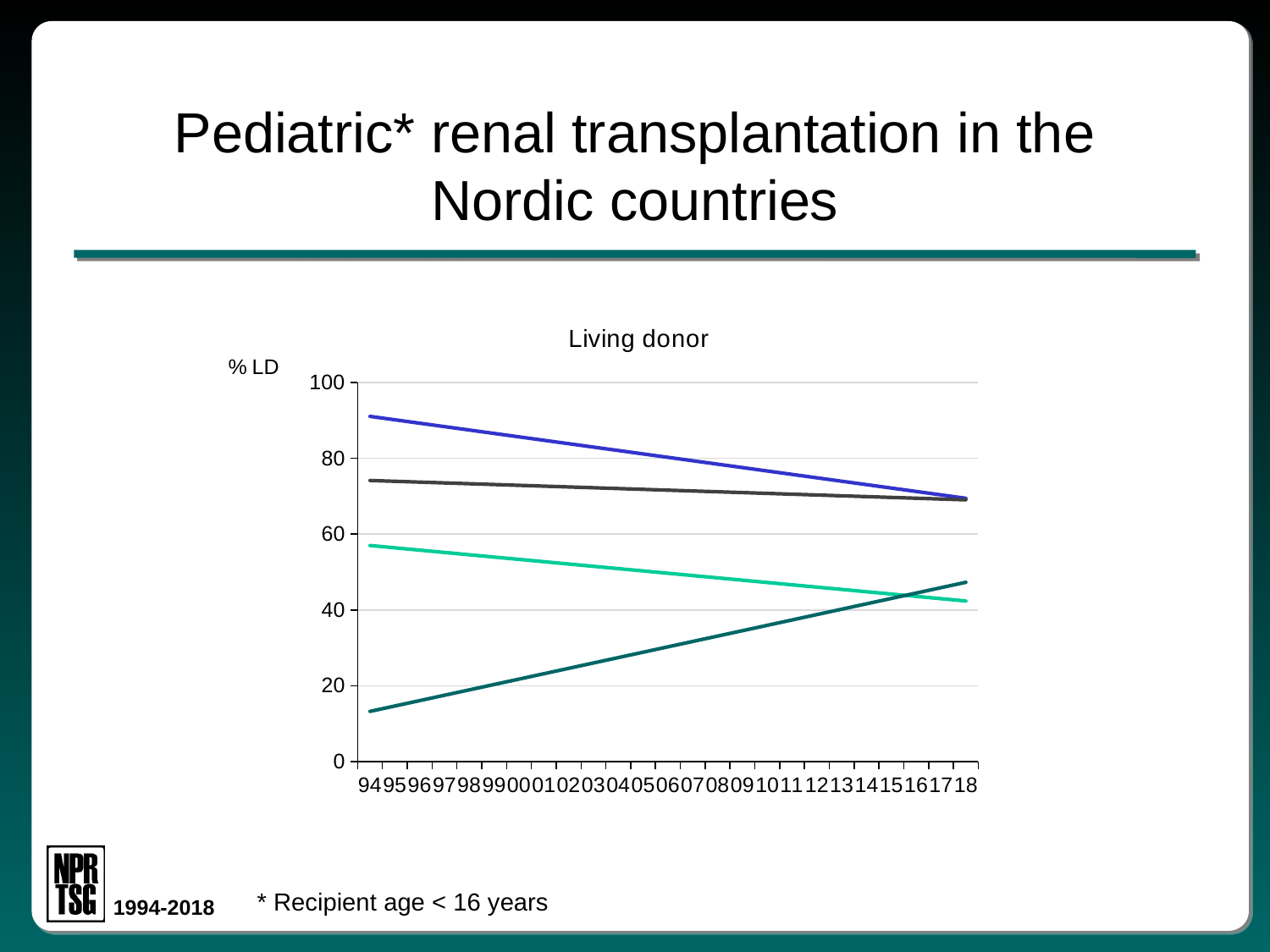
What kind of chart is shown on the slide? line chart Does the dark teal line rise or fall from 94 to 18? rise Which line has the highest value at 94? the blue line What is the title of the chart? Living donor How many lines are plotted on the chart? 4 What is the label on the y axis of the chart? % LD Does the blue line rise or fall from 94 to 18? fall Does the light green line rise or fall from 94 to 18? fall Which line has the lowest value at 94? the dark teal line How many year labels are shown along the x axis? 25 Is the value of the dark teal line at 94 greater or less than 20? less Is the value of the blue line at 94 greater or less than 80? greater